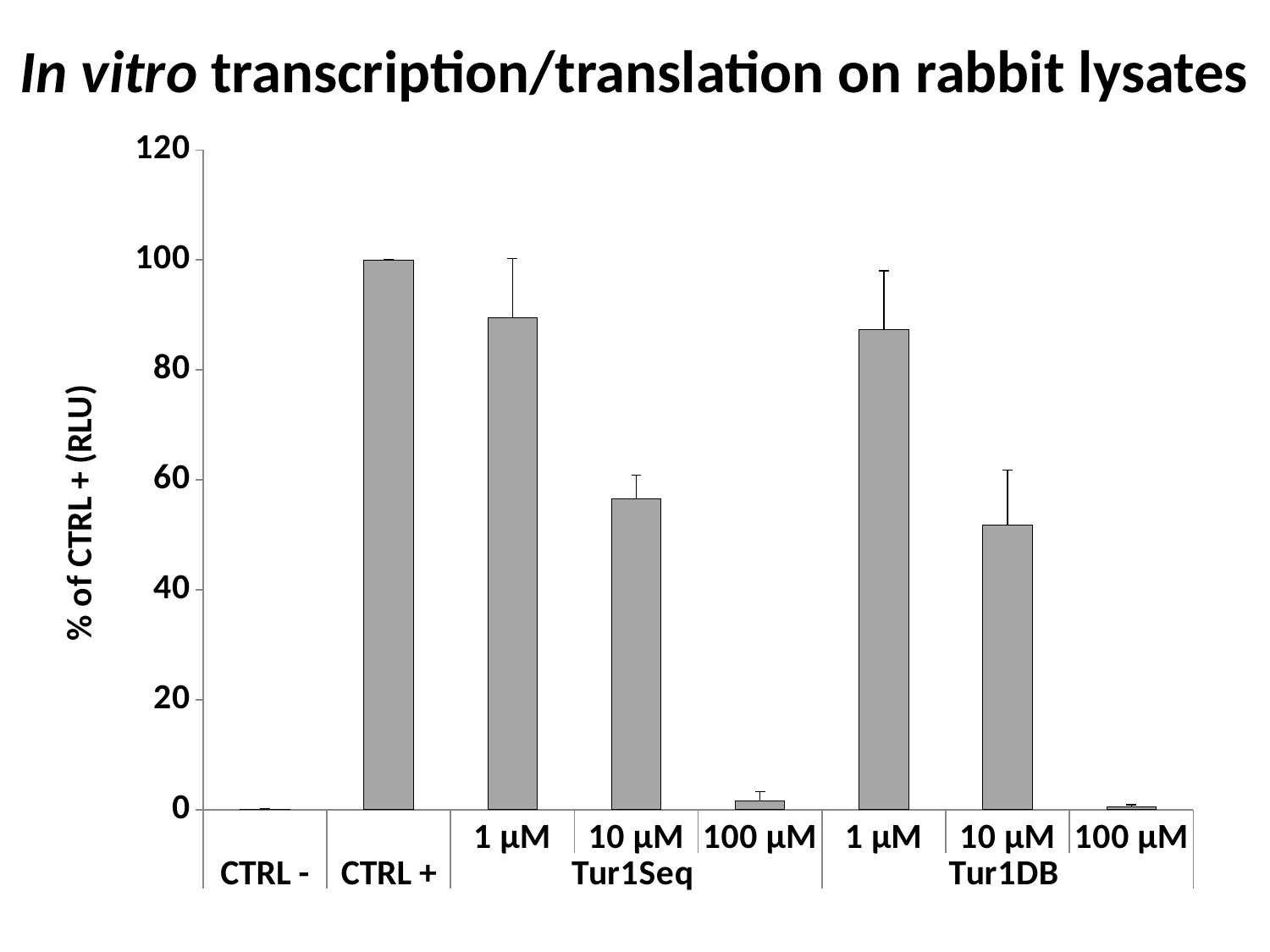
Which is larger, the value for Tur1DB at 1 µM or Tur1DB at 100 µM? Tur1DB at 1 µM What type of chart is shown on the slide? bar chart For Tur1DB, do the values rise or fall as the concentration increases from 1 µM to 100 µM? fall What is the value for CTRL +? 100 Is the value for Tur1Seq at 10 µM greater or less than 60? less Is the value for Tur1Seq at 1 µM greater or less than 80? greater How many bars are plotted in the chart? 8 What is the label of the y axis? % of CTRL + (RLU) Which is larger, the value for Tur1Seq at 1 µM or Tur1Seq at 10 µM? Tur1Seq at 1 µM Which category has the highest value? CTRL + Is the value for Tur1DB at 100 µM greater or less than 20? less